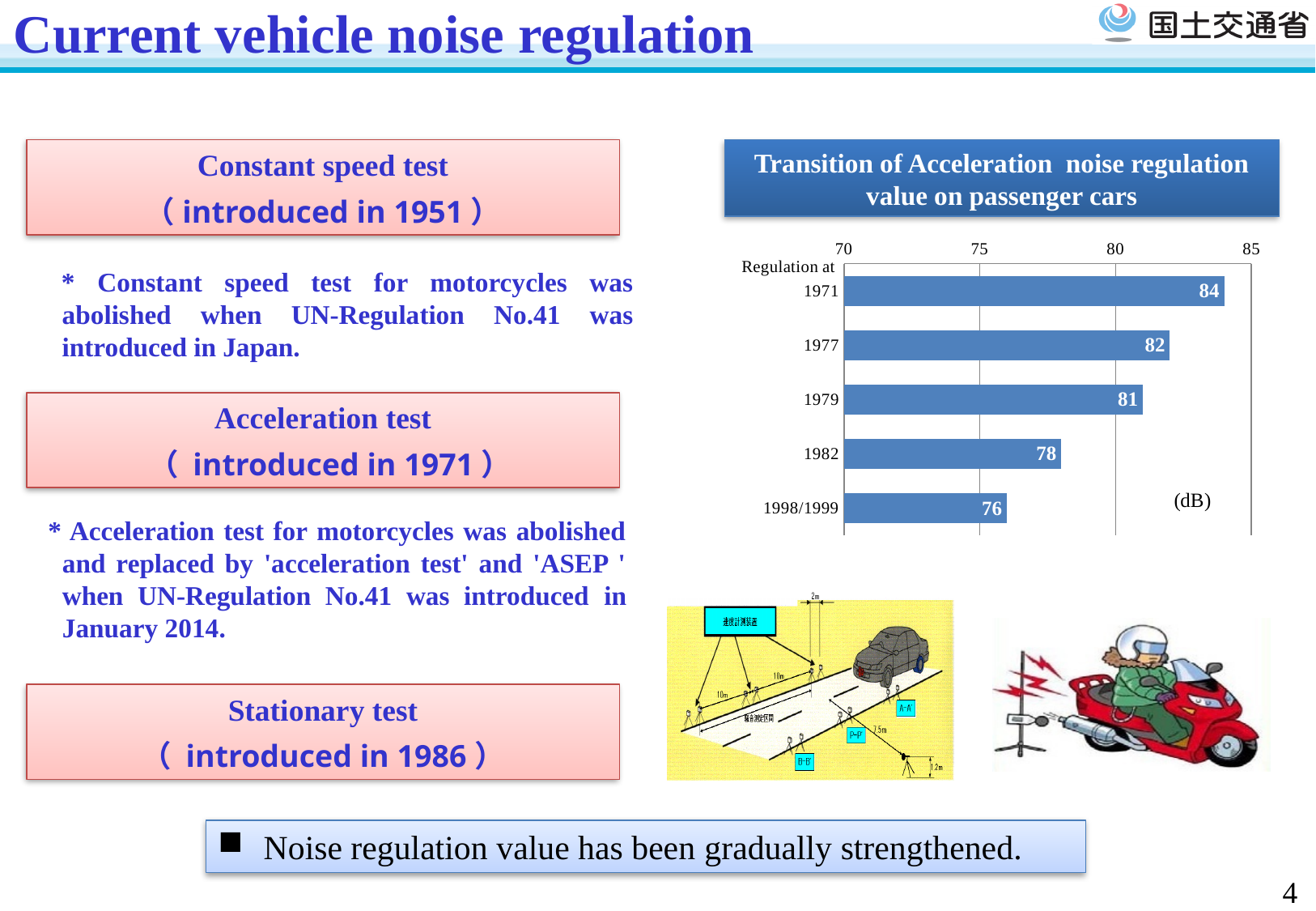
What is the difference between the regulation values for 1971 and 1998/1999? 8 Is the regulation value for 1982 greater or less than 80? less What is the regulation value for 1998/1999 in the chart? 76 How many categories (regulation years) are shown in the chart? 5 What is the difference between the regulation values for 1977 and 1979? 1 What is the regulation value for 1971 in the chart? 84 What is the regulation value for 1982 in the chart? 78 What kind of chart is shown on the slide? bar chart Which year has the highest regulation value in the chart? 1971 Which is larger, the regulation value for 1979 or for 1982? 1979 Which category has the lowest regulation value in the chart? 1998/1999 What is the title of the chart on the slide? Transition of Acceleration noise regulation value on passenger cars